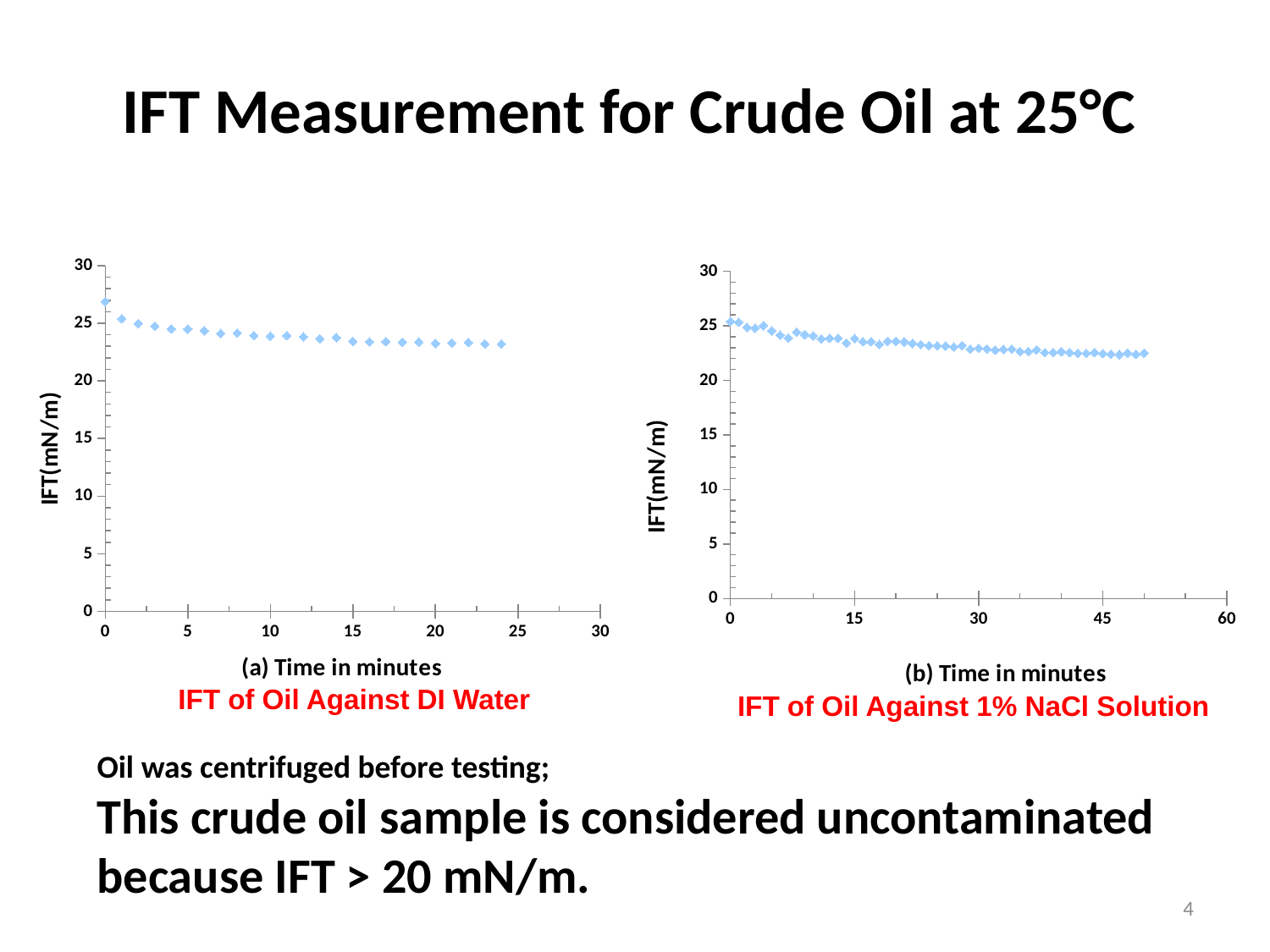
In the left chart, 'IFT of Oil Against DI Water', do the IFT values rise or fall as time increases? fall What is the x-axis label of the left chart, 'IFT of Oil Against DI Water'? (a) Time in minutes In the left chart, 'IFT of Oil Against DI Water', which is larger: the IFT value at 0 minutes or at 10 minutes? 0 minutes In the right chart, 'IFT of Oil Against 1% NaCl Solution', is the IFT value at 45 minutes greater or less than 25? less In the right chart, 'IFT of Oil Against 1% NaCl Solution', is the IFT value at 30 minutes greater or less than 20? greater What kind of chart is the left chart, 'IFT of Oil Against DI Water'? scatter chart In the left chart, 'IFT of Oil Against DI Water', is the IFT value at time 0 greater or less than 25? greater What is the y-axis label of the right chart, 'IFT of Oil Against 1% NaCl Solution'? IFT(mN/m) In the left chart, 'IFT of Oil Against DI Water', at what time is the IFT value highest? 0 minutes In the right chart, 'IFT of Oil Against 1% NaCl Solution', do the IFT values rise or fall as time increases? fall